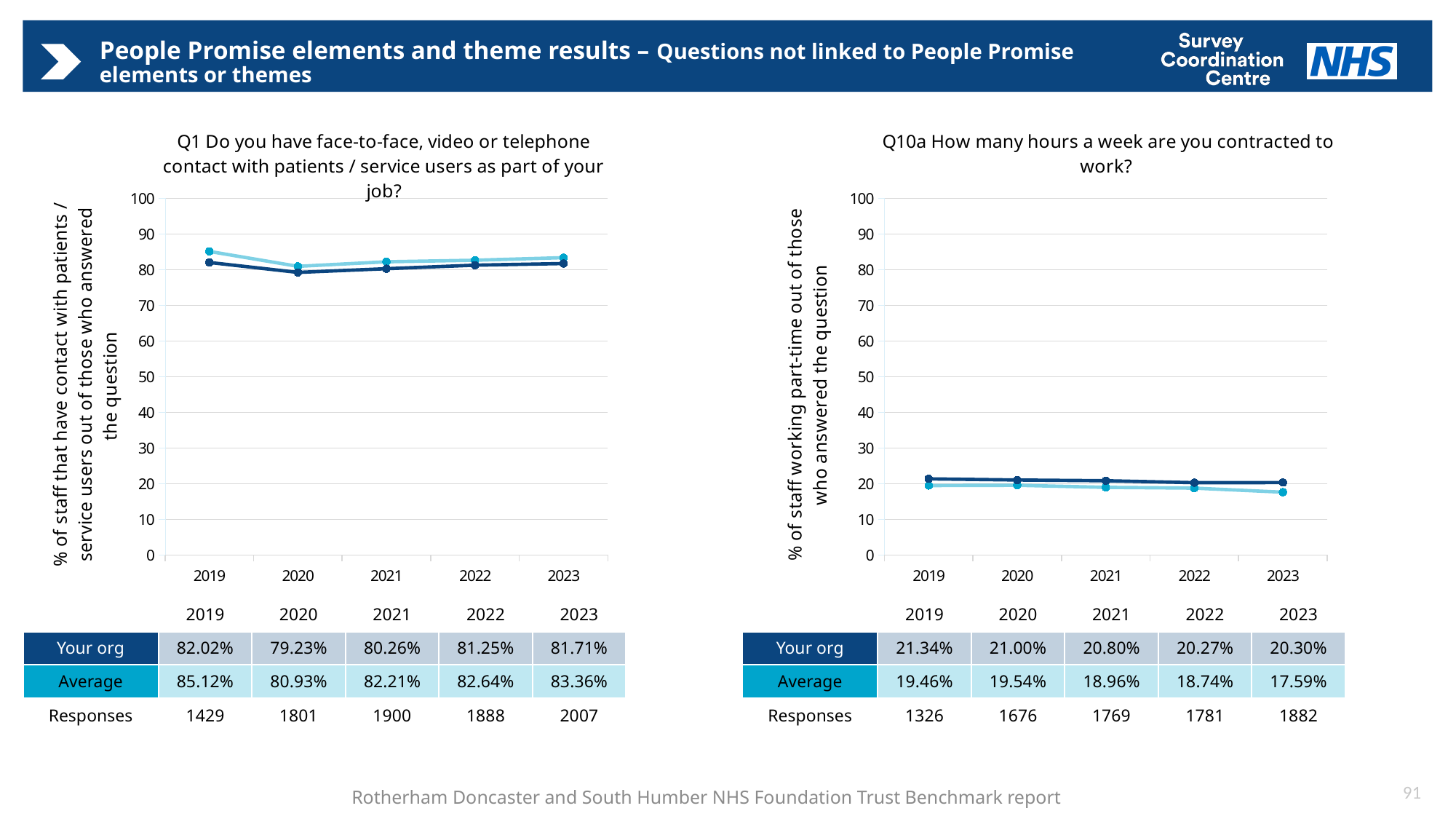
In the Q10a chart, what is the difference between the Your org and Average values in 2023? 2.71% In the Q1 chart, what is the difference between the Average and Your org values in 2019? 3.10% In the Q1 chart, what is the Average value for 2023? 83.36% In the Q10a chart, which is larger in 2021: Your org or Average? Your org How many years are plotted on the x axis of the Q1 chart? 5 In the Q10a chart, does the Average line rise or fall from 2020 to 2023? Fall In the Q1 chart (face-to-face, video or telephone contact with patients), what is the Your org value for 2020? 79.23% In the Q10a chart (hours a week contracted to work), what is the Your org value for 2019? 21.34% In the Q1 chart, which year has the lowest Your org value? 2020 In the Q10a chart, which year has the highest Your org value? 2019 What kind of chart is the Q10a chart? Line chart In the Q10a chart, what is the Average value for 2023? 17.59%